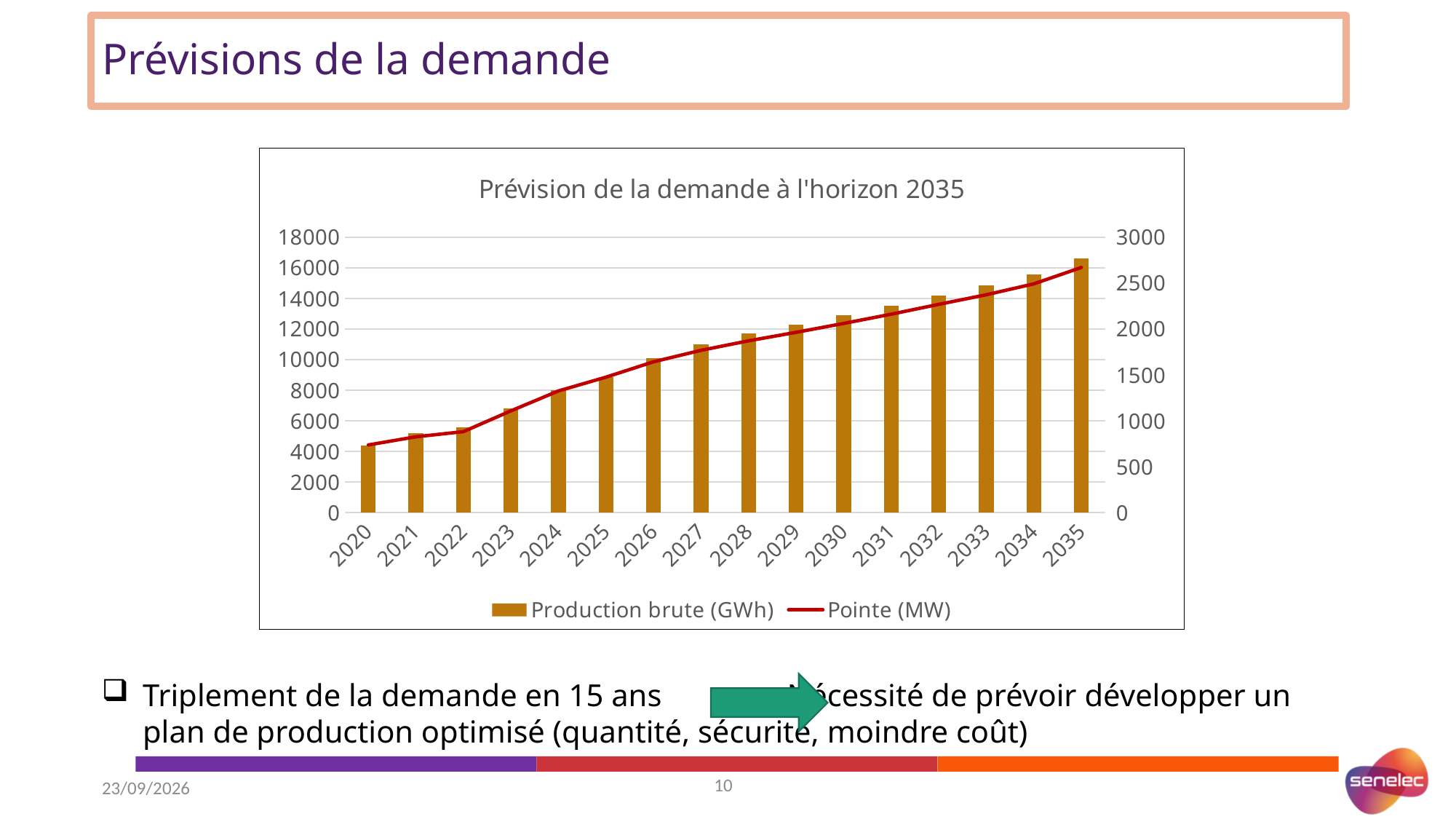
Which year has the highest Production brute (GWh)? 2035 Do the Production brute (GWh) values rise or fall from 2020 to 2035? Rise Is the Production brute (GWh) value for 2025 greater or less than 10000? less What is the title of the chart? Prévision de la demande à l'horizon 2035 Is the Production brute (GWh) value for 2020 greater or less than 6000? less Which year has the lowest Production brute (GWh)? 2020 Is the Production brute (GWh) value for 2035 greater or less than 14000? greater How many years are shown on the x axis? 16 How many series does the legend list? 2 Which series is drawn as a line? Pointe (MW) What kind of chart is shown on the slide? A combined bar and line chart